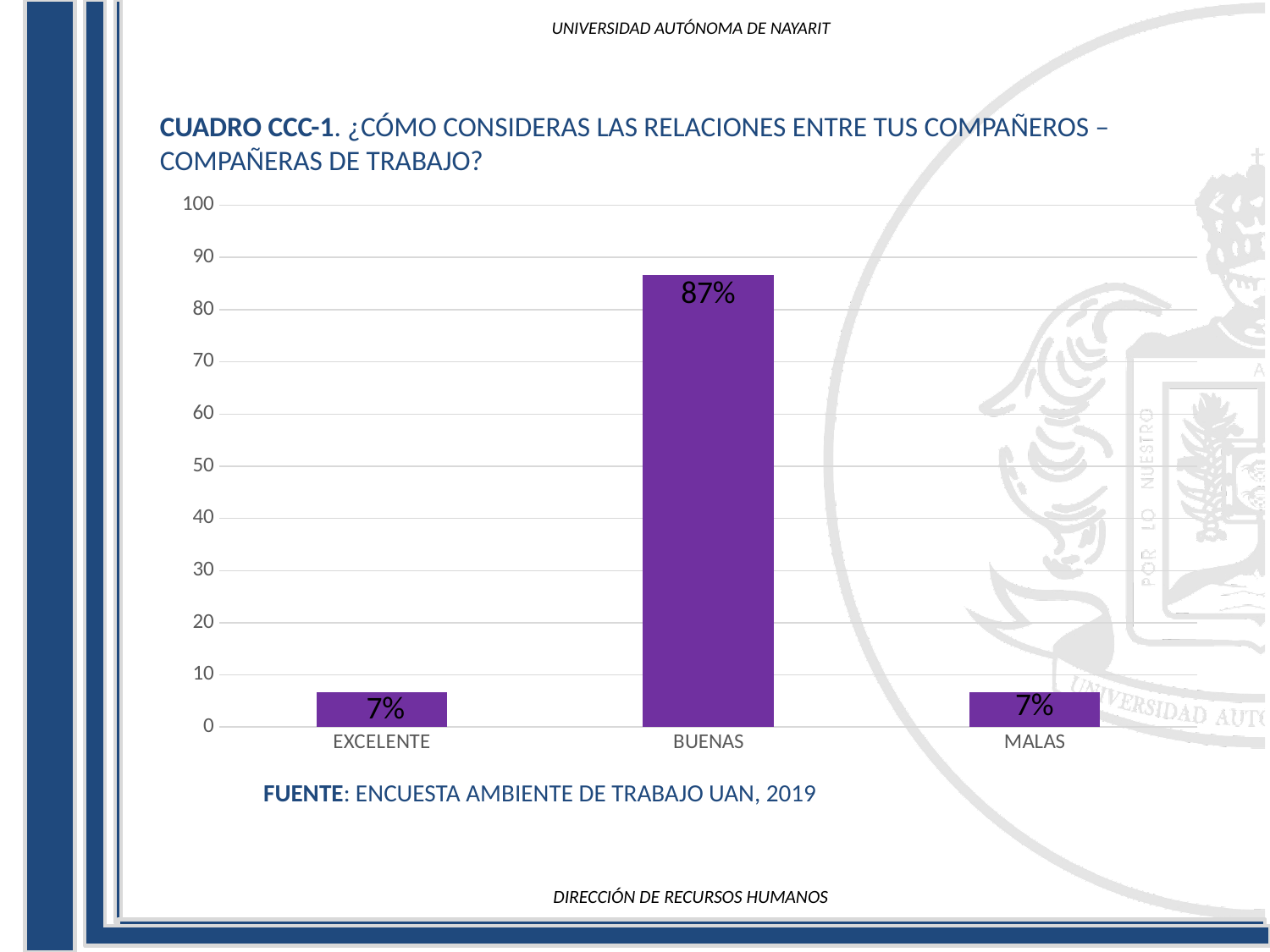
What kind of chart is shown on the slide? bar chart Is the value for EXCELENTE greater or less than 10? less Which category has the highest value? BUENAS What is the value for MALAS? 7% Is the value for BUENAS greater or less than 80? greater How many categories are shown on the x axis? 3 Which is larger, the value for BUENAS or the value for MALAS? BUENAS What is the value for BUENAS? 87% What is the value for EXCELENTE? 7% What is the maximum value shown on the y axis? 100 What is the difference between the values for BUENAS and EXCELENTE? 80% What is the source cited below the chart? ENCUESTA AMBIENTE DE TRABAJO UAN, 2019